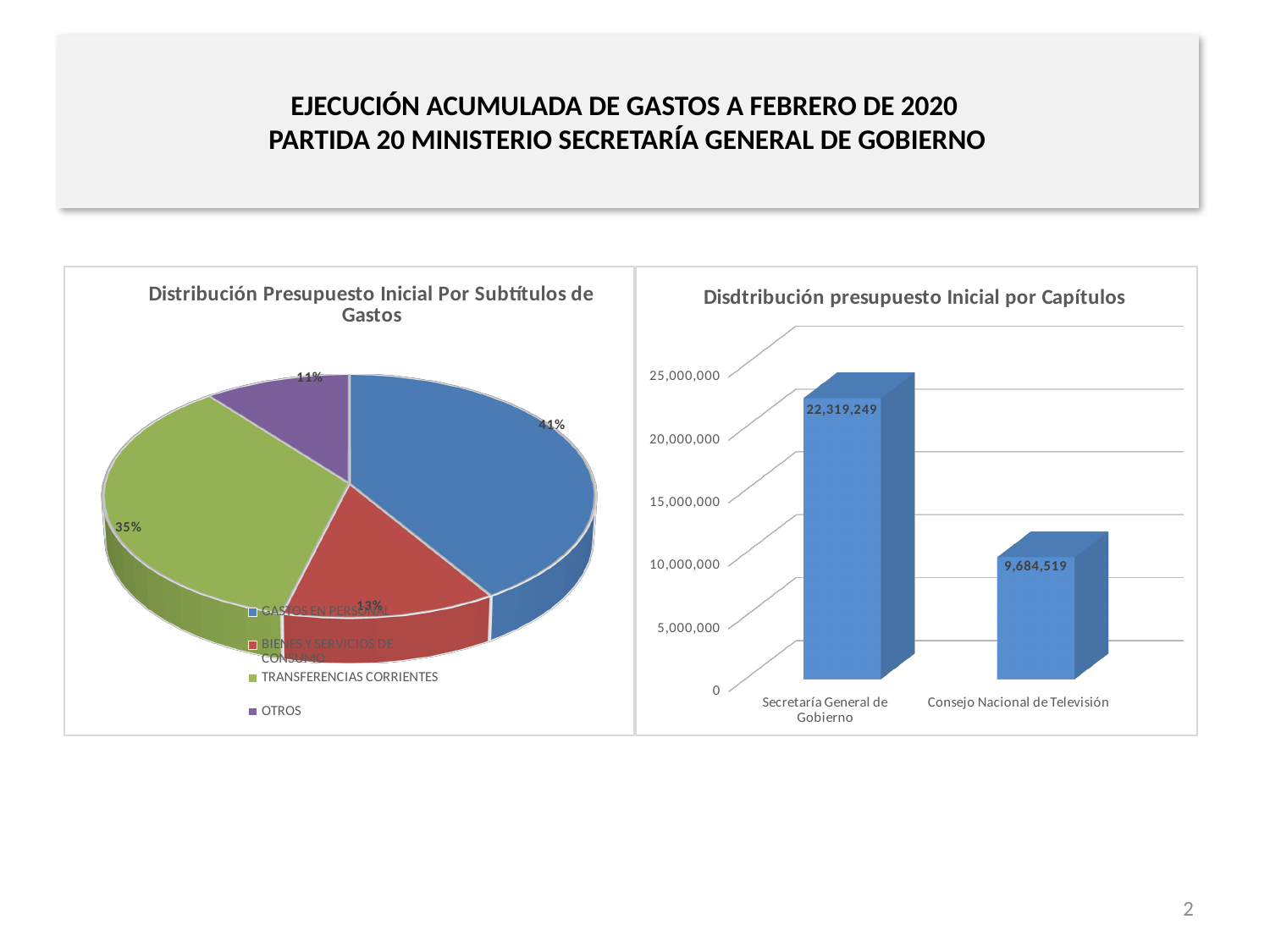
In the pie chart on the left, which category has the largest share? GASTOS EN PERSONAL In the pie chart on the left, which category has the smallest share? OTROS In the bar chart on the right, what is the value for Consejo Nacional de Televisión? 9,684,519 In the bar chart on the right, is the value for Consejo Nacional de Televisión greater or less than 10,000,000? less In the pie chart on the left, what share does BIENES Y SERVICIOS DE CONSUMO have? 13% In the bar chart on the right, what is the difference between Secretaría General de Gobierno and Consejo Nacional de Televisión? 12,634,730 What kind of chart is the chart on the right, titled 'Disdtribución presupuesto Inicial por Capítulos'? Bar chart How many slices does the pie chart on the left have? 4 In the pie chart on the left, what share does OTROS have? 11% In the bar chart on the right, what is the value for Secretaría General de Gobierno? 22,319,249 In the pie chart on the left, what share does GASTOS EN PERSONAL have? 41%